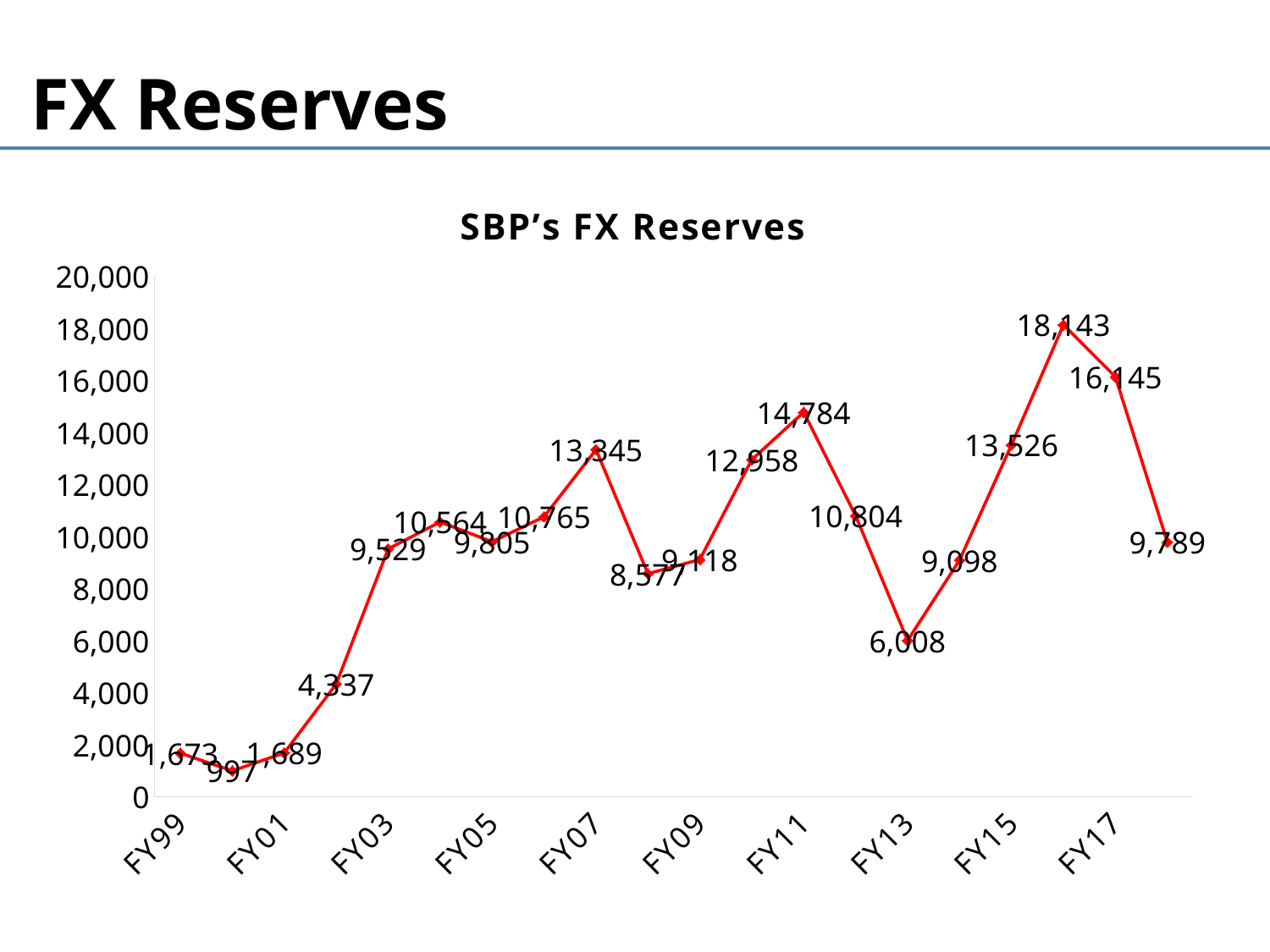
What is the lowest value plotted on the chart? 997 What is the value of SBP's FX Reserves for FY11? 14,784 How many data points are plotted on the line? 20 What is the title of the chart? SBP's FX Reserves What is the highest value plotted on the chart? 18,143 What is the value of SBP's FX Reserves for FY13? 6,008 What is the difference between the FY11 value and the FY13 value? 8,776 Which is larger, the value for FY11 or the value for FY15? FY11 What is the value of SBP's FX Reserves for FY17? 16,145 Is the value for FY13 greater or less than 8,000? less What type of chart is shown on the slide? line chart What is the value of SBP's FX Reserves for FY99? 1,673